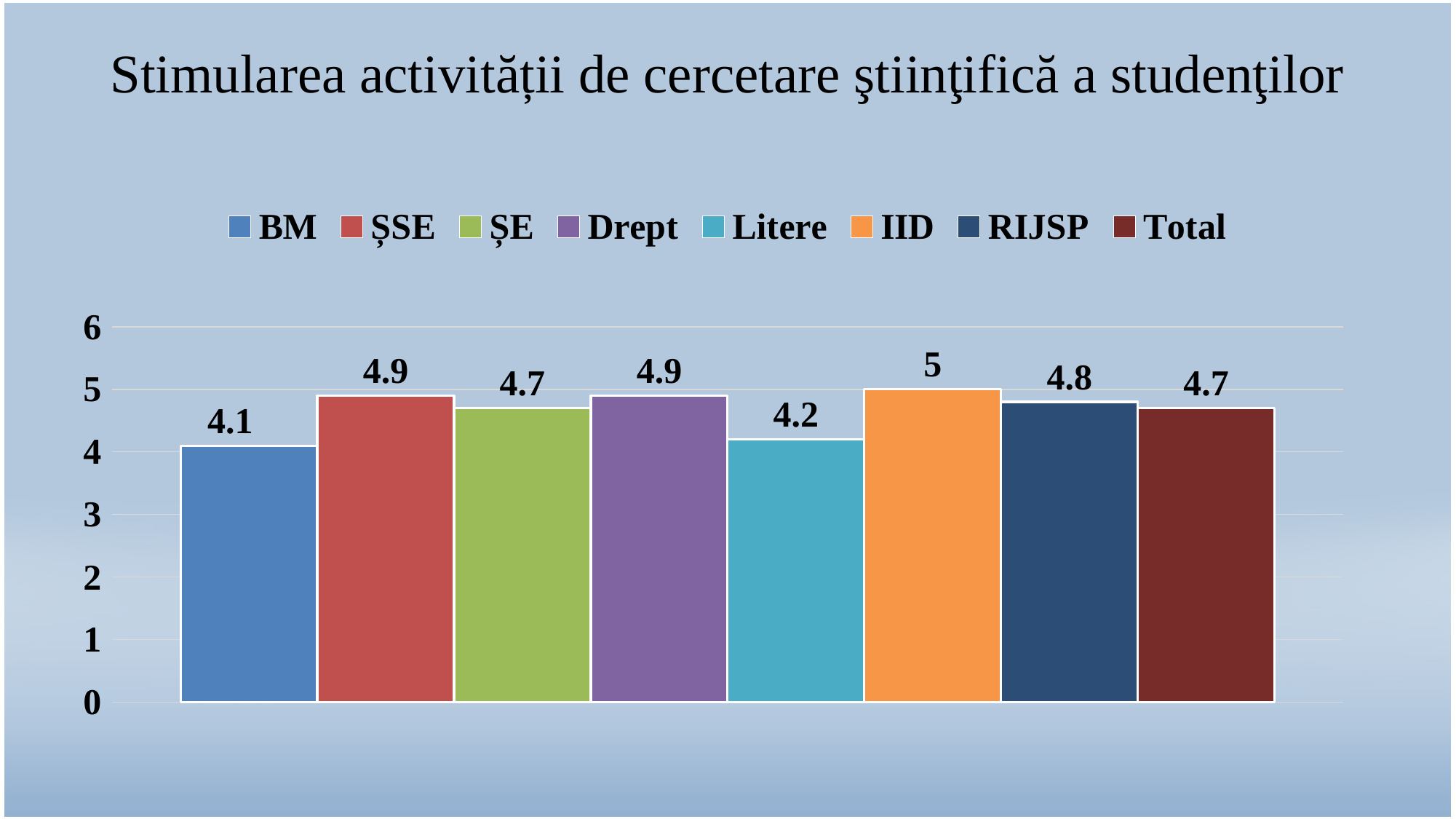
What is the value for Litere? 4.2 How many series does the legend list? 8 Which category has the lowest value? BM What is the title of the chart? Stimularea activității de cercetare ştiinţifică a studenţilor What kind of chart is shown on the slide? Bar chart What is the value for RIJSP? 4.8 Which is larger, the value for Drept or the value for Litere? Drept What is the value for IID? 5 What is the value for BM? 4.1 Which category has the highest value? IID What is the difference between the values for ȘSE and Litere? 0.7 What is the difference between the values for IID and BM? 0.9